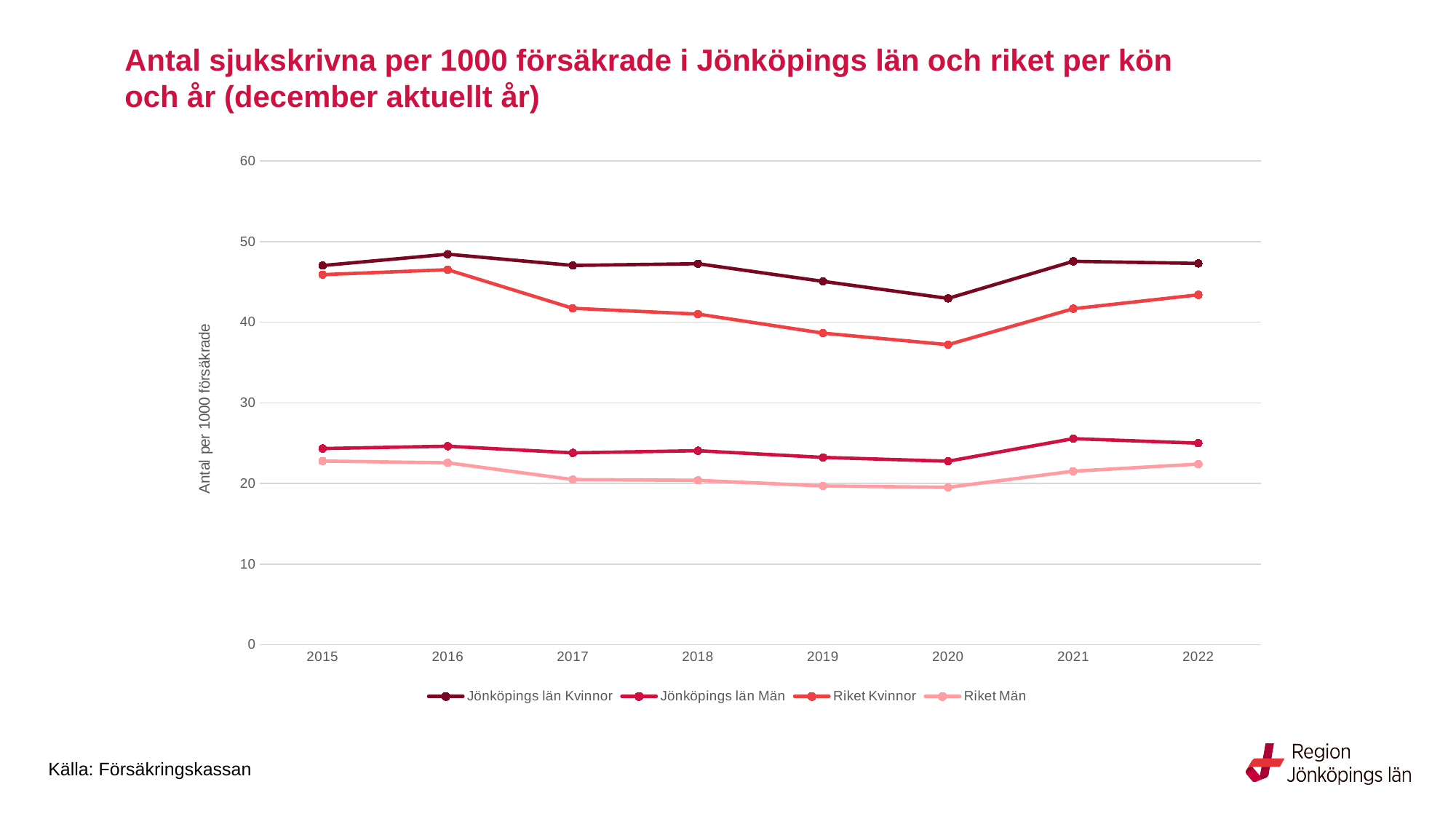
What is the label on the y axis of the chart? Antal per 1000 försäkrade In which year is the value for Riket Kvinnor lowest? 2020 In 2020, which is larger: Jönköpings län Kvinnor or Riket Kvinnor? Jönköpings län Kvinnor What kind of chart is shown on the slide? Line chart In which year is the value for Jönköpings län Män highest? 2021 Is the value for Riket Kvinnor in 2020 greater or less than 40? less Is the value for Jönköpings län Kvinnor in 2016 greater or less than 50? less In which year is the value for Jönköpings län Kvinnor highest? 2016 How many series does the legend list? 4 Is the value for Riket Män in 2015 greater or less than 20? greater How many years are shown on the x axis? 8 Does the value for Riket Kvinnor rise or fall from 2016 to 2020? fall